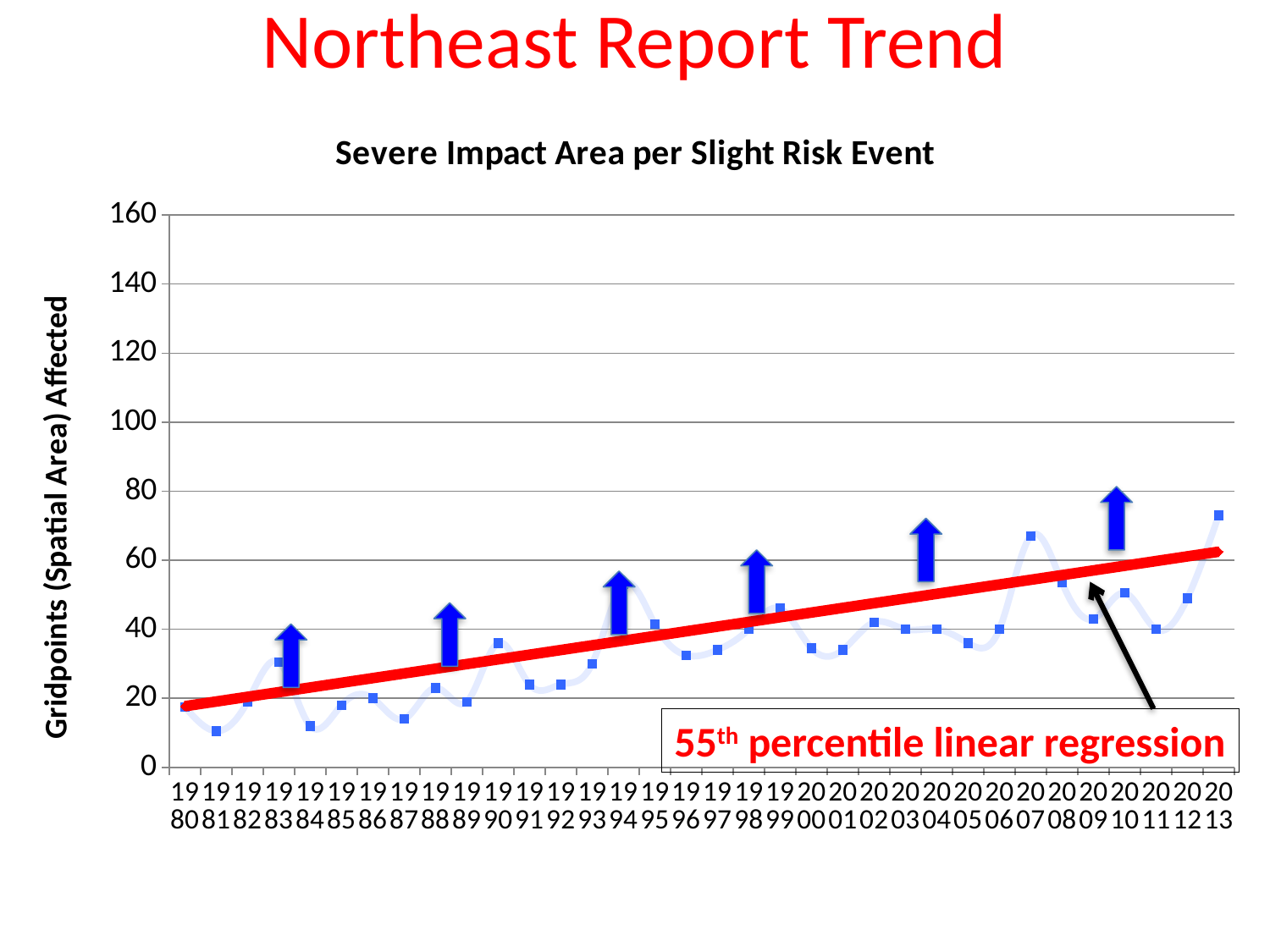
Is the value for 2013 greater or less than 60? greater Is the value for 1981 greater or less than 20? less Do the values generally rise or fall from 1980 to 2013 according to the red regression line? rise Is the value for 1994 greater or less than 40? greater What kind of chart is shown on the slide? line chart What is the title of the chart? Severe Impact Area per Slight Risk Event Which year has the larger value, 2013 or 1981? 2013 How many years are plotted along the x axis of the chart? 34 What is the label on the vertical axis of the chart? Gridpoints (Spatial Area) Affected Which year has the highest value in the chart? 2013